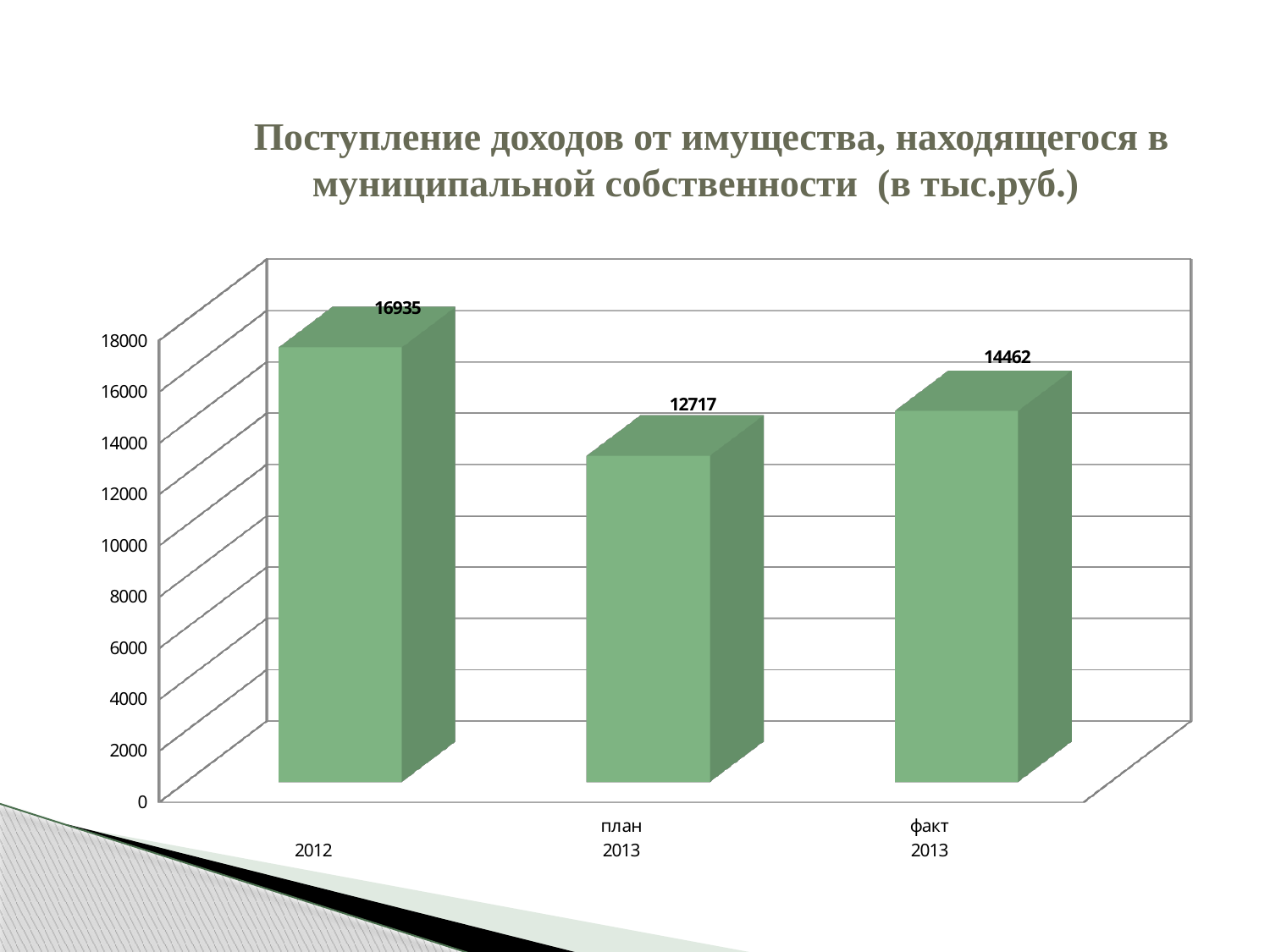
What is the difference between the values for факт 2013 and план 2013? 1745 What is the value for план 2013? 12717 What is the difference between the values for 2012 and факт 2013? 2473 What unit is stated in the chart title? тыс.руб. Which category has the lowest value? план 2013 What is the value for 2012? 16935 How many bars are shown in the chart? 3 What is the value for факт 2013? 14462 Is the value for план 2013 greater or less than 14000? less Which category has the highest value? 2012 Which is larger, the value for план 2013 or the value for факт 2013? факт 2013 What kind of chart is shown on the slide? bar chart